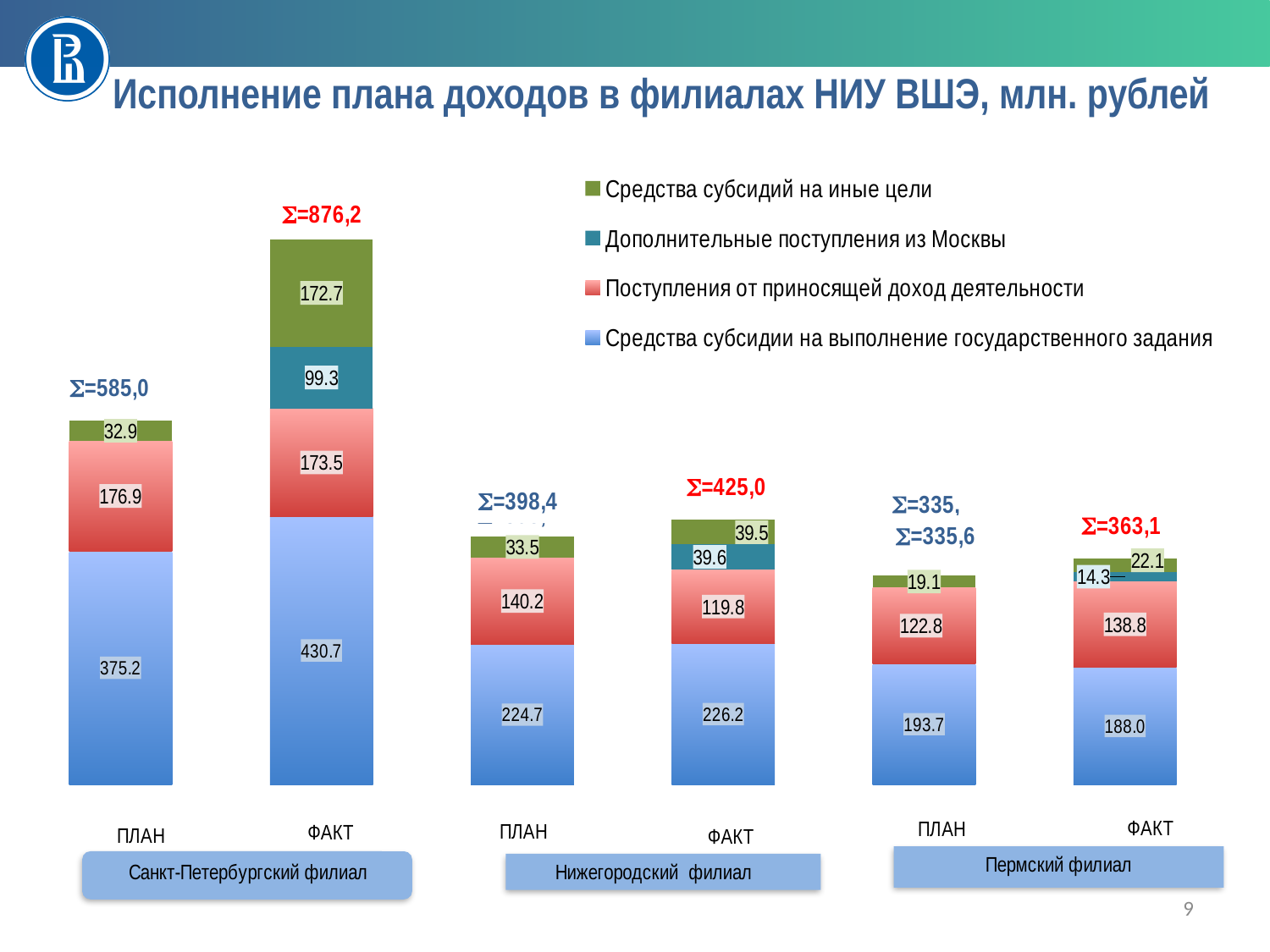
How many branches (филиалы) are shown on the chart? 3 What is the total shown for the ПЛАН bar of Нижегородский филиал? 398,4 What kind of chart is shown on the slide? stacked bar chart What is the total shown for the ФАКТ bar of Санкт-Петербургский филиал? 876,2 What is the value of 'Средства субсидии на выполнение государственного задания' for the ФАКТ bar of Санкт-Петербургский филиал? 430.7 Which bar has the lowest total on the chart? ПЛАН, Пермский филиал Which bar has the highest total on the chart? ФАКТ, Санкт-Петербургский филиал Which is larger for Пермский филиал: the ПЛАН or the ФАКТ value of 'Поступления от приносящей доход деятельности'? ФАКТ What is the value of 'Дополнительные поступления из Москвы' for the ФАКТ bar of Нижегородский филиал? 39.6 What is the difference between the ФАКТ and ПЛАН values of 'Средства субсидии на выполнение государственного задания' for Санкт-Петербургский филиал? 55.5 How many series does the legend list? 4 What is the value of 'Поступления от приносящей доход деятельности' for the ПЛАН bar of Пермский филиал? 122.8